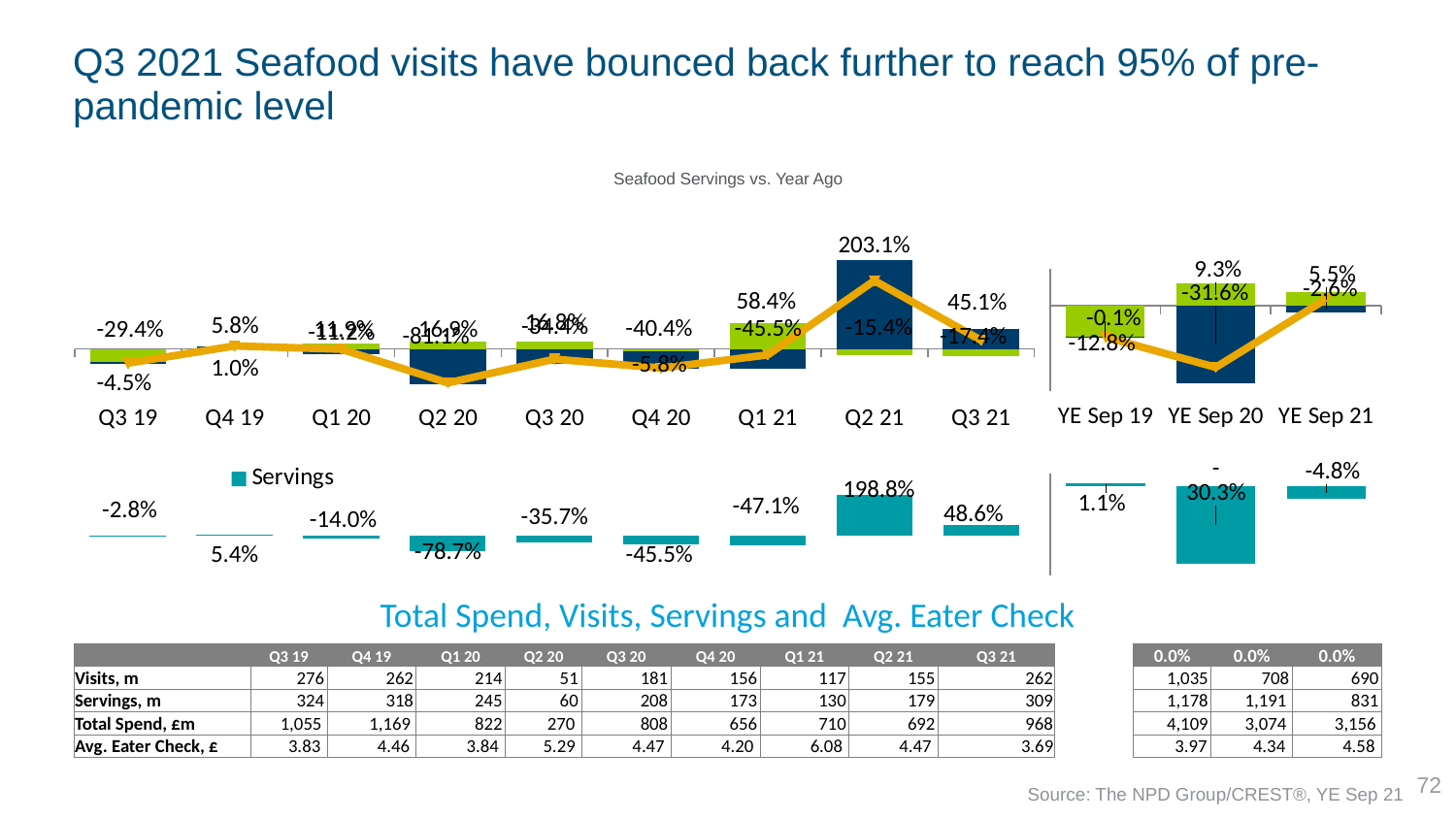
How many quarters are shown in the bottom 'Servings' chart? 9 In the bottom 'Servings' chart, what is the value for Q2 21? 198.8% What kind of chart is the bottom 'Servings' chart? Bar chart In the bottom-right year-ending chart, what is the value for YE Sep 20? -30.3% In the bottom-right year-ending chart, what is the value for YE Sep 21? -4.8% In the bottom 'Servings' chart, which quarter has the highest value? Q2 21 In the bottom 'Servings' chart, what is the value for Q2 20? -78.7% In the bottom 'Servings' chart, what is the difference between the Q2 21 value and the Q3 21 value? 150.2 percentage points In the top 'Seafood Servings vs. Year Ago' chart, what is the highest value labelled, at Q2 21? 203.1% In the bottom 'Servings' chart, which is larger, the value for Q3 20 or the value for Q4 20? Q3 20 In the bottom 'Servings' chart, which quarter has the lowest value? Q2 20 What is the title of the top chart? Seafood Servings vs. Year Ago